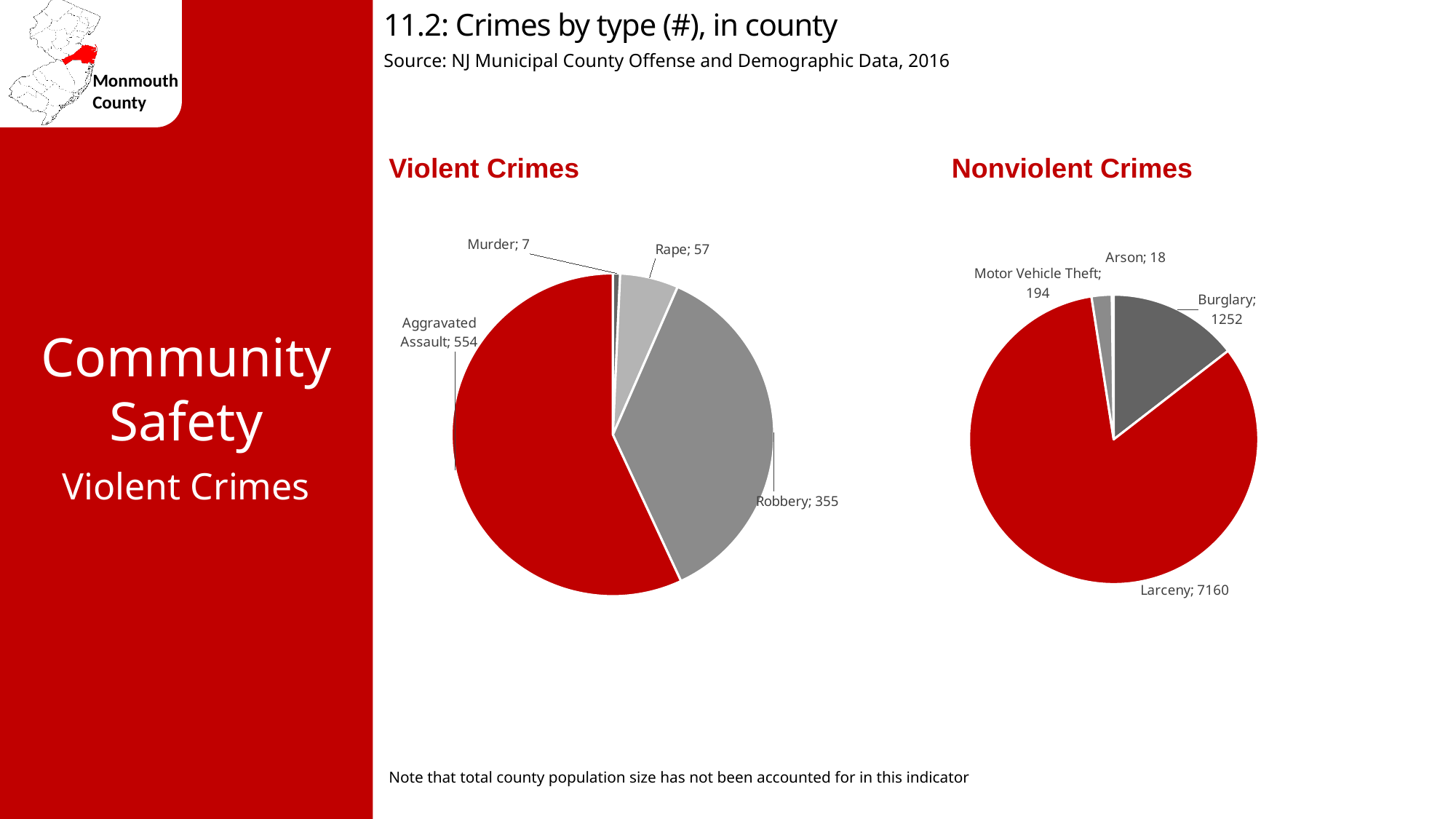
In the Nonviolent Crimes pie chart, what is the difference between Larceny and Burglary? 5908 In the Nonviolent Crimes pie chart, what is the value for Burglary? 1252 In the Violent Crimes pie chart, which is larger, Rape or Murder? Rape In the Violent Crimes pie chart, which crime type has the smallest value? Murder What is the total of all values in the Violent Crimes pie chart? 973 In the Nonviolent Crimes pie chart, which crime type has the largest value? Larceny In the Violent Crimes pie chart, what is the value for Robbery? 355 In the Violent Crimes pie chart, what is the difference between Aggravated Assault and Robbery? 199 How many categories does the Nonviolent Crimes pie chart show? 4 In the Nonviolent Crimes pie chart, what is the value for Motor Vehicle Theft? 194 In the Violent Crimes pie chart, how many aggravated assaults are shown? 554 What kind of chart is used for Violent Crimes? Pie chart